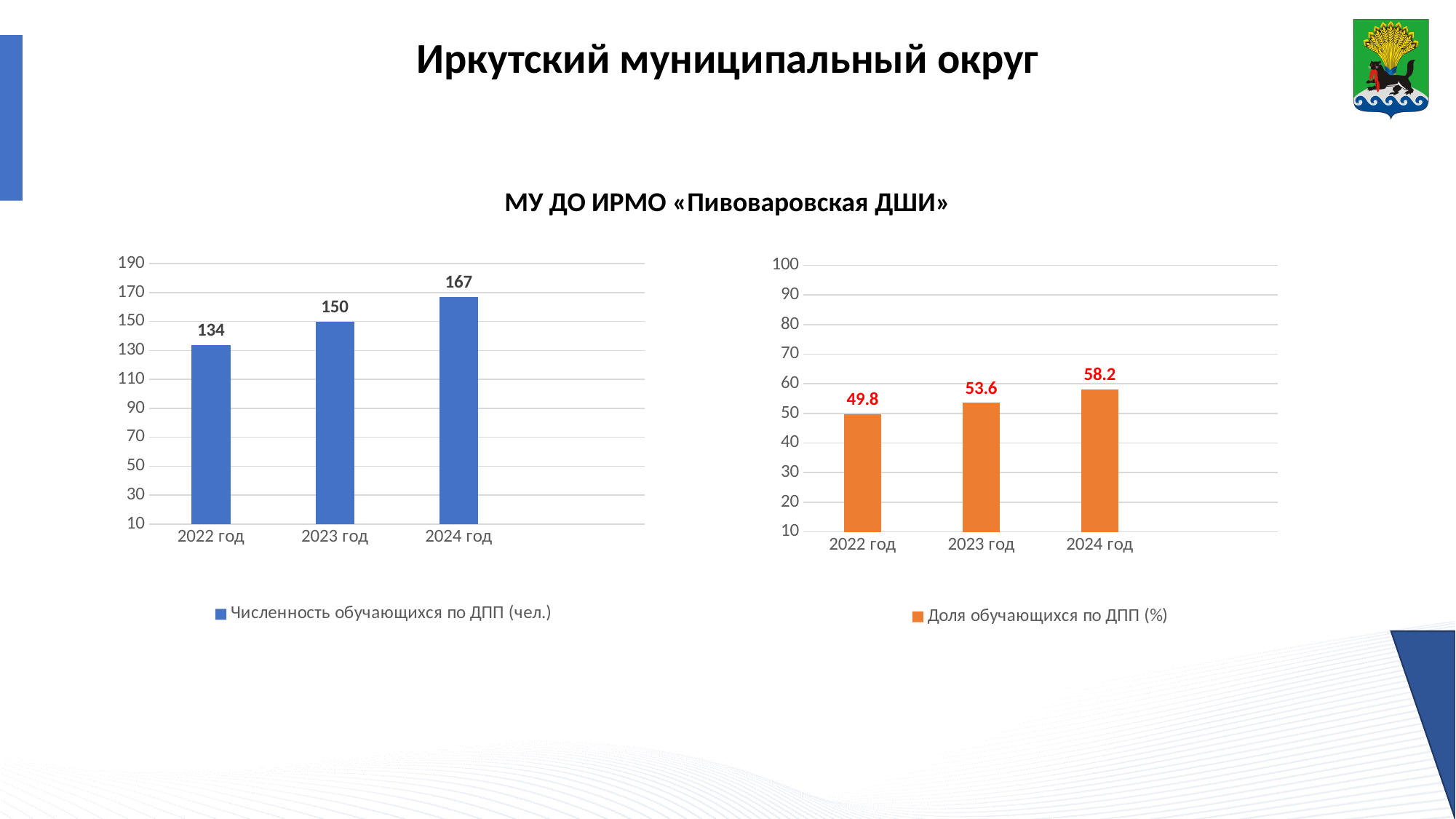
How many categories are shown on the x axis of the right chart (Доля обучающихся по ДПП)? 3 In the left chart (Численность обучающихся по ДПП), which is larger: the value for 2023 год or 2024 год? 2024 год In the right chart (Доля обучающихся по ДПП), what is the value for 2022 год? 49.8 In the right chart (Доля обучающихся по ДПП), do the values rise or fall from 2022 год to 2024 год? Rise In the right chart (Доля обучающихся по ДПП), which year has the lowest value? 2022 год In the right chart (Доля обучающихся по ДПП), what is the difference between the values for 2023 год and 2022 год? 3.8 What kind of chart is the left chart (Численность обучающихся по ДПП)? Bar chart In the left chart (Численность обучающихся по ДПП), what is the value for 2022 год? 134 In the left chart (Численность обучающихся по ДПП), what is the difference between the values for 2024 год and 2022 год? 33 In the right chart (Доля обучающихся по ДПП), what is the value for 2024 год? 58.2 In the left chart (Численность обучающихся по ДПП), which year has the highest value? 2024 год In the left chart (Численность обучающихся по ДПП), what is the value for 2023 год? 150